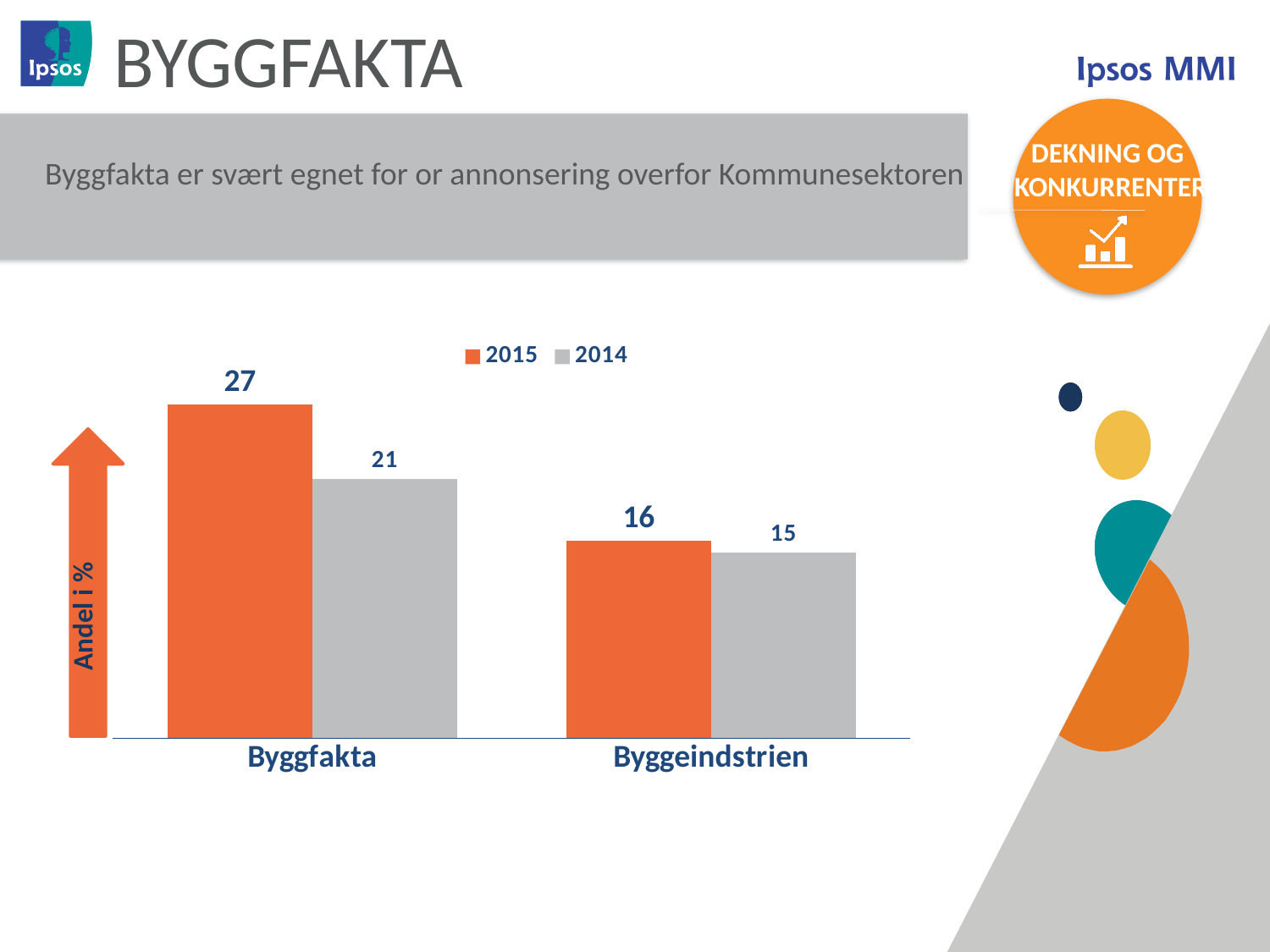
What is the value for Byggeindustrien in 2015? 16 What is the value for Byggfakta in 2014? 21 How many categories are shown on the x axis? 2 Which category has the highest 2015 value? Byggfakta What is the value for Byggeindustrien in 2014? 15 What is the value for Byggfakta in 2015? 27 What kind of chart is shown on the slide? Bar chart How many series does the legend list? 2 Which category has the lowest 2014 value? Byggeindstrien What is the difference between the 2015 values for Byggfakta and Byggeindustrien? 11 Which is larger: the 2015 value for Byggfakta or the 2014 value for Byggfakta? 2015 value for Byggfakta What is the difference between the 2015 and 2014 values for Byggfakta? 6